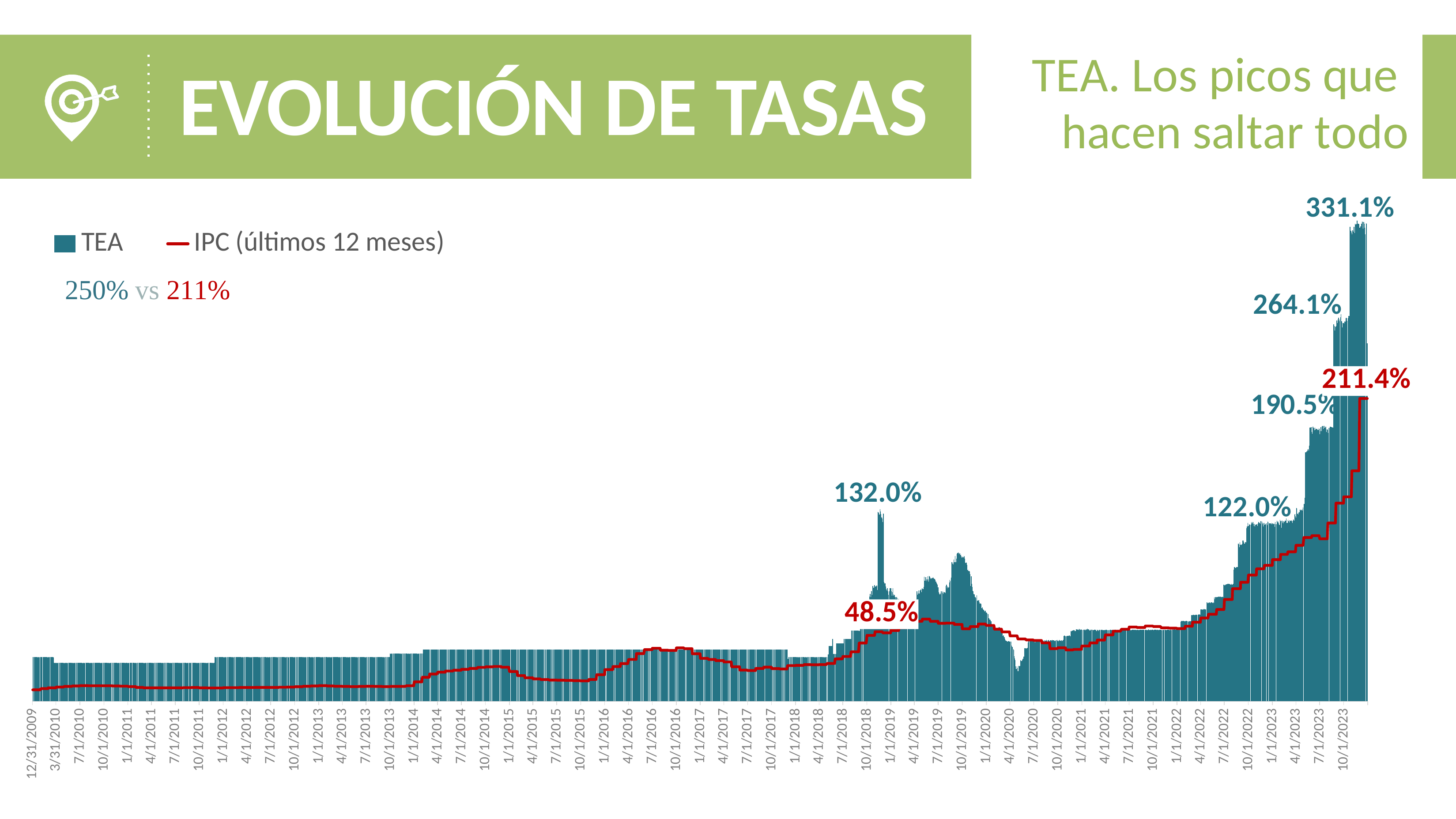
What is the labelled TEA peak value around late 2018 / early 2019? 132.0% By how much does the labelled IPC value of 211.4% exceed the earlier labelled IPC value of 48.5%? 162.9 percentage points How many series does the chart legend list? 2 What is the highest labelled value of the TEA series? 331.1% What is the difference between the 331.1% and 264.1% labelled TEA peaks? 67.0 percentage points What are the two series named in the chart legend? TEA and IPC (últimos 12 meses) What is the final labelled value of the IPC (últimos 12 meses) line at the right end of the chart? 211.4% What is the labelled IPC (últimos 12 meses) value shown near late 2018? 48.5% What is the first date shown on the x axis? 12/31/2009 Which labelled TEA peak is larger, 264.1% or 190.5%? 264.1% What kind of chart is used to show the TEA series? Bar chart Does the TEA series generally rise or fall from 2009 to 2023? Rise